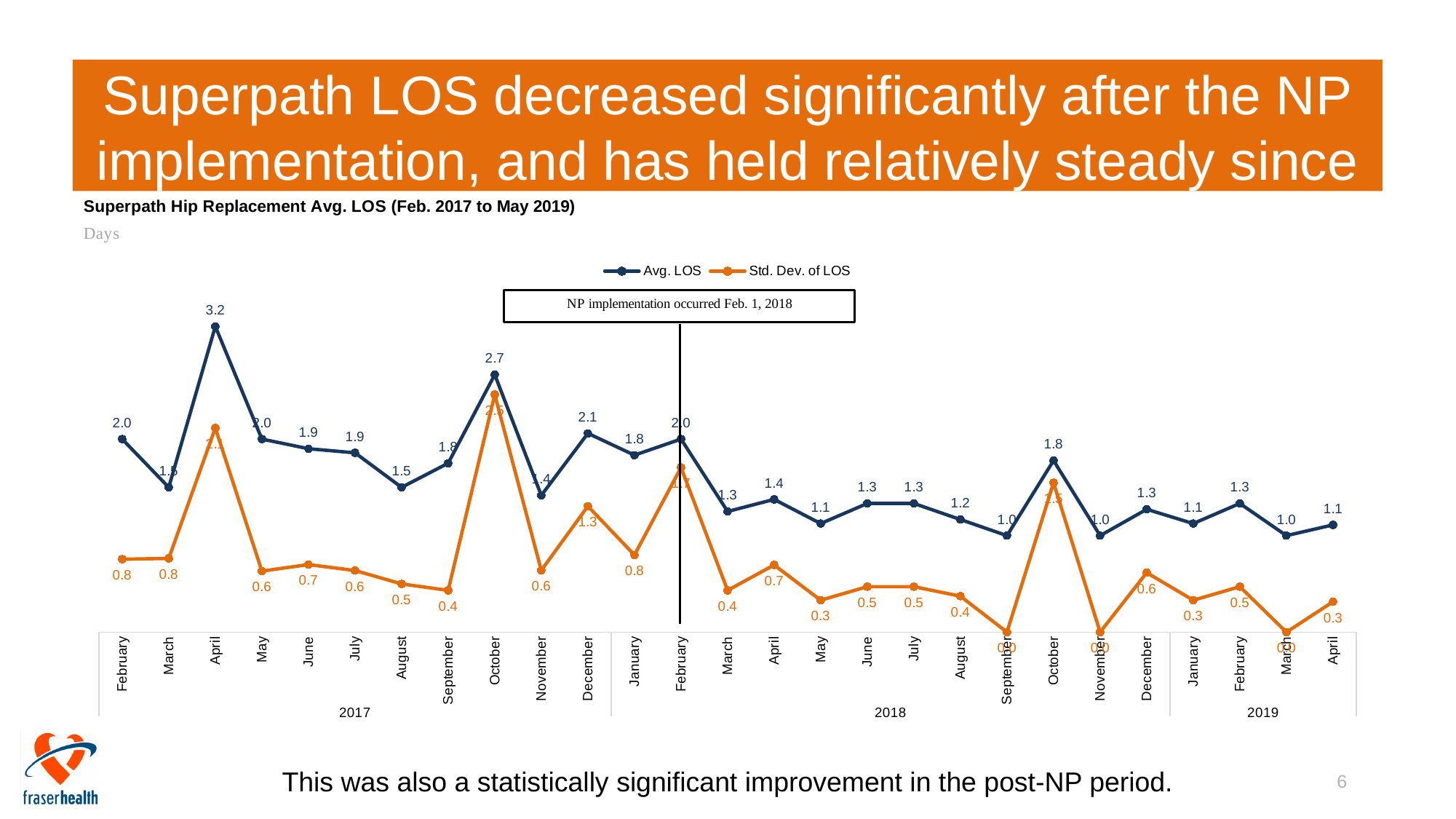
How many monthly data points are plotted for each series? 27 Which is larger, the Avg. LOS in October 2017 or in October 2018? October 2017 In which month is the Avg. LOS highest? April 2017 What is the difference between the Avg. LOS in April 2017 and October 2017? 0.5 What is the Avg. LOS value for February 2018? 2.0 What kind of chart is shown on the slide? Line chart What is the Avg. LOS value for October 2017? 2.7 What is the Std. Dev. of LOS value for September 2017? 0.4 Does the Avg. LOS rise or fall from February 2018 to March 2018? Fall What are the two series named in the legend? Avg. LOS and Std. Dev. of LOS What is the Std. Dev. of LOS value for December 2017? 1.3 How many series does the legend list? 2